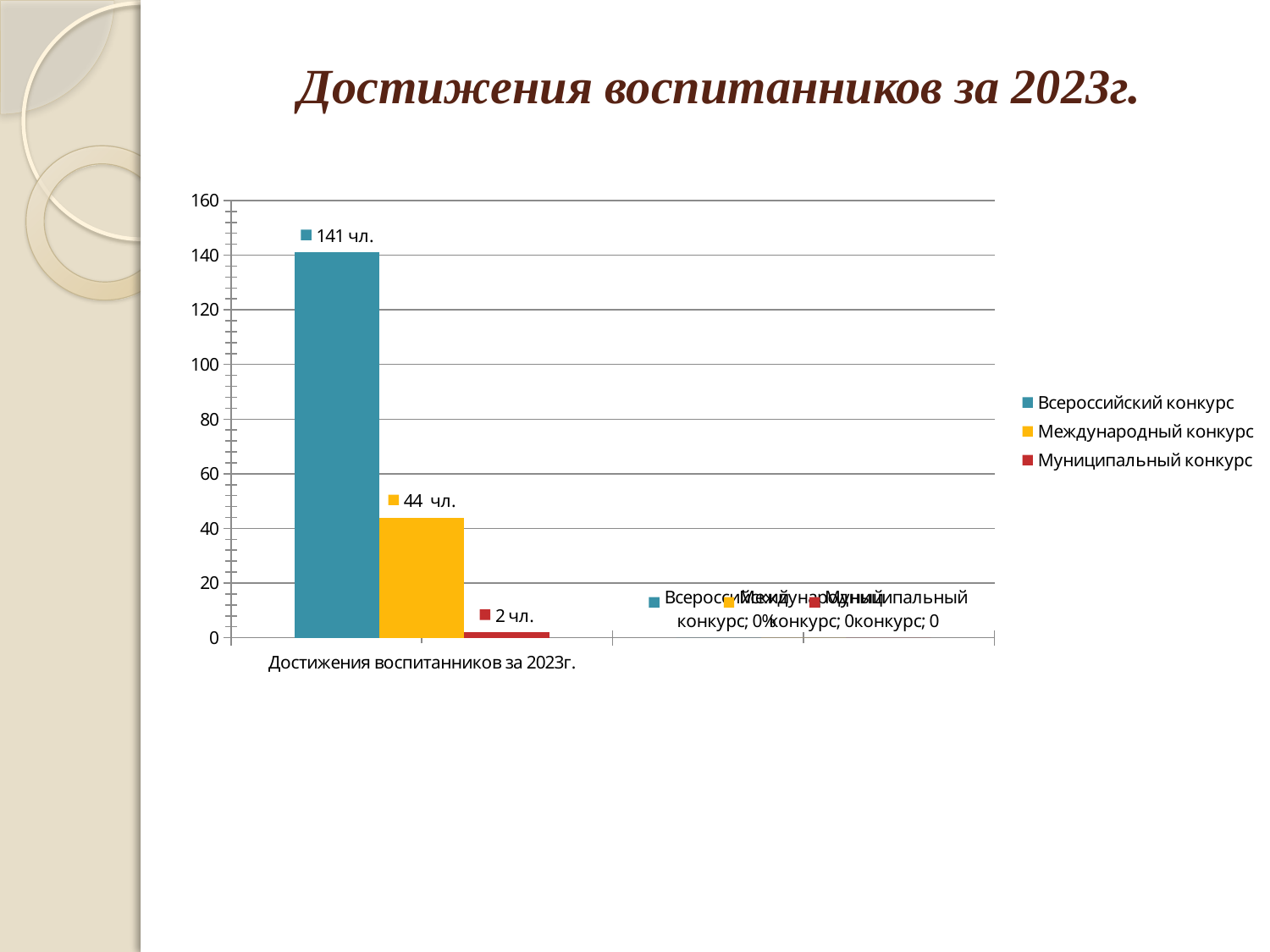
Which series has the highest value? Всероссийский конкурс Which is larger, the value for Международный конкурс or the value for Муниципальный конкурс? Международный конкурс What kind of chart is shown on the slide? bar chart Which series has the lowest value? Муниципальный конкурс What is the difference between the values for Международный конкурс and Муниципальный конкурс? 42 What is the title of the slide? Достижения воспитанников за 2023г. Is the value for Всероссийский конкурс greater or less than 120? greater How many series does the legend list? 3 What value is shown for Всероссийский конкурс? 141 чл. What value is shown for Муниципальный конкурс? 2 чл. What value is shown for Международный конкурс? 44 чл. What is the difference between the values for Всероссийский конкурс and Международный конкурс? 97